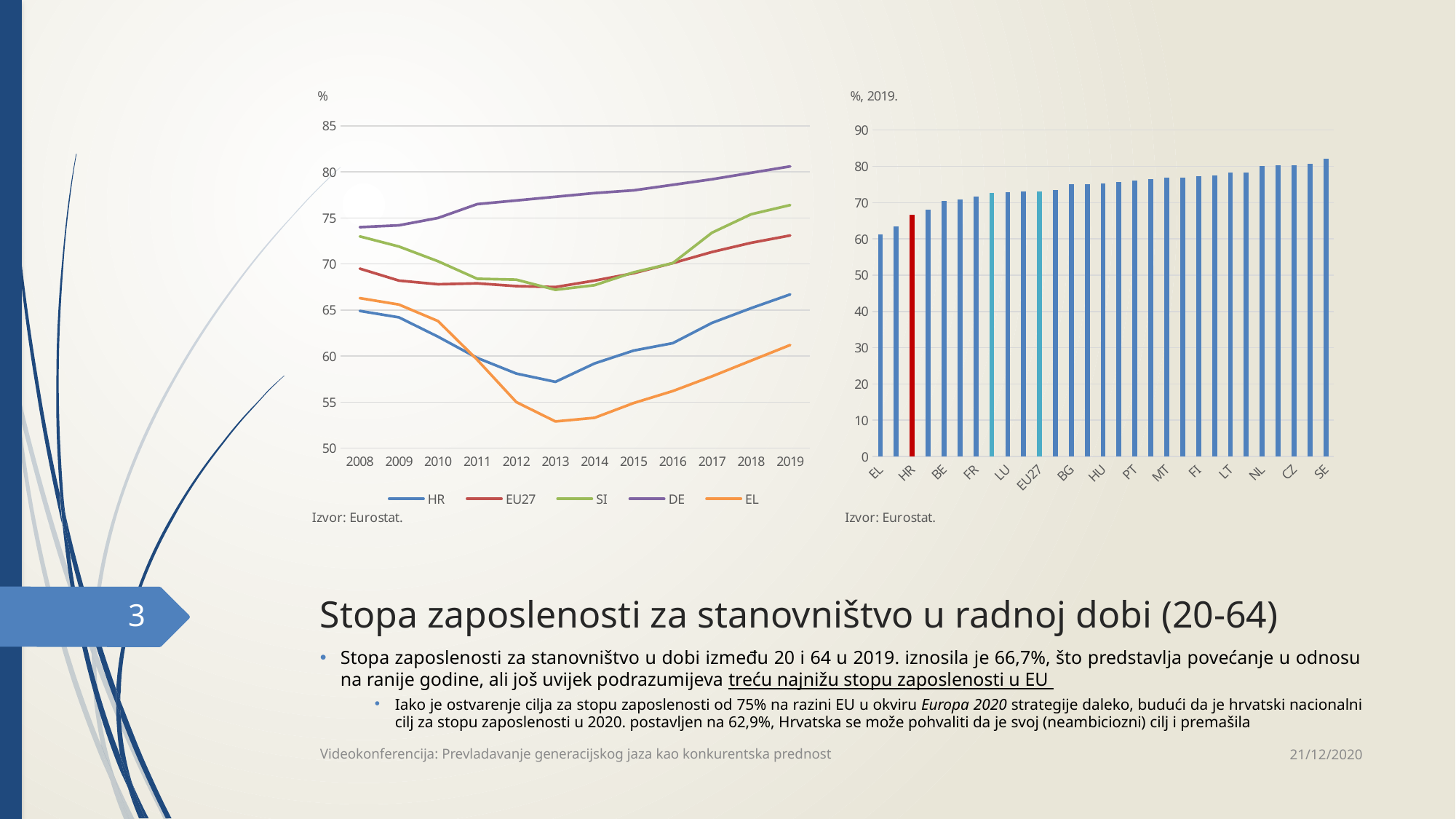
In the right bar chart (%, 2019.), which country has the lowest value? EL What type of chart is the chart on the right side of the slide (%, 2019.)? bar chart How many series does the legend of the left line chart list? 5 In the left line chart, is the value for HR in 2013 greater or less than 60? less In the left line chart, does the value for EL rise or fall from 2008 to 2013? fall In the left line chart, which is larger in 2019, the value for HR or the value for EL? HR In the left line chart, which series has the highest value in 2019? DE How many years are shown on the x axis of the left line chart? 12 In the left line chart, is the value for EU27 in 2019 greater or less than 70? greater In the left line chart, which series has the lowest value in 2019? EL What type of chart is the chart on the left side of the slide? line chart In the right bar chart (%, 2019.), which country has the highest value? SE